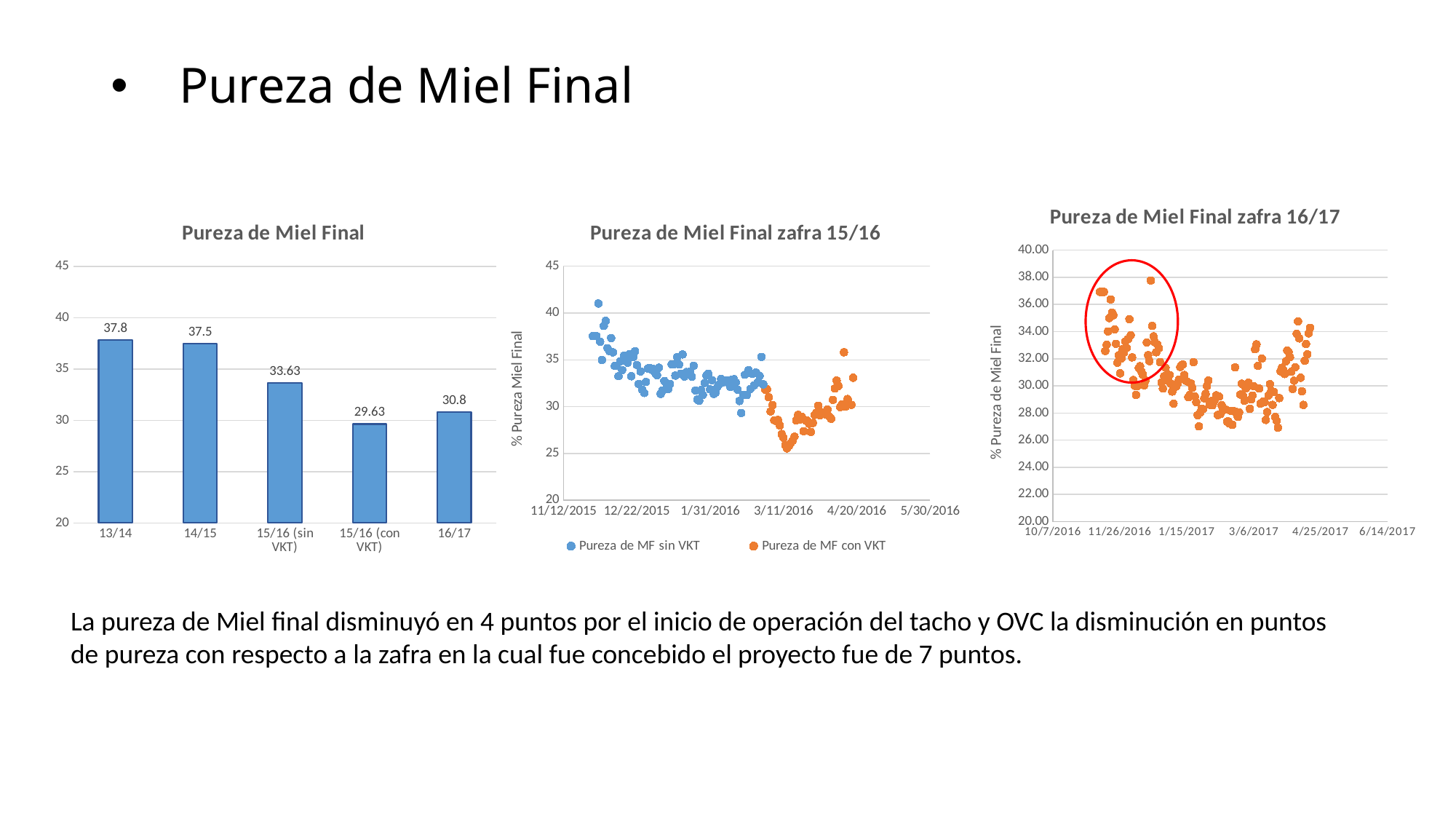
In the 'Pureza de Miel Final' bar chart, which category has the lowest value? 15/16 (con VKT) What kind of chart is the leftmost chart titled 'Pureza de Miel Final'? Bar chart In the 'Pureza de Miel Final' bar chart, what is the difference between the values for 15/16 (sin VKT) and 15/16 (con VKT)? 4 In the 'Pureza de Miel Final' bar chart, what is the value for 15/16 (con VKT)? 29.63 How many series does the legend of the 'Pureza de Miel Final zafra 15/16' chart list? 2 In the 'Pureza de Miel Final' bar chart, what is the value for 13/14? 37.8 In the 'Pureza de Miel Final zafra 15/16' chart, what is the label of the orange series in the legend? Pureza de MF con VKT In the 'Pureza de Miel Final' bar chart, which category has the highest value? 13/14 In the 'Pureza de Miel Final' bar chart, what is the value for 16/17? 30.8 How many categories are shown in the 'Pureza de Miel Final' bar chart? 5 In the 'Pureza de Miel Final' bar chart, which is larger, the value for 14/15 or the value for 16/17? 14/15 What kind of chart is 'Pureza de Miel Final zafra 16/17'? Scatter chart